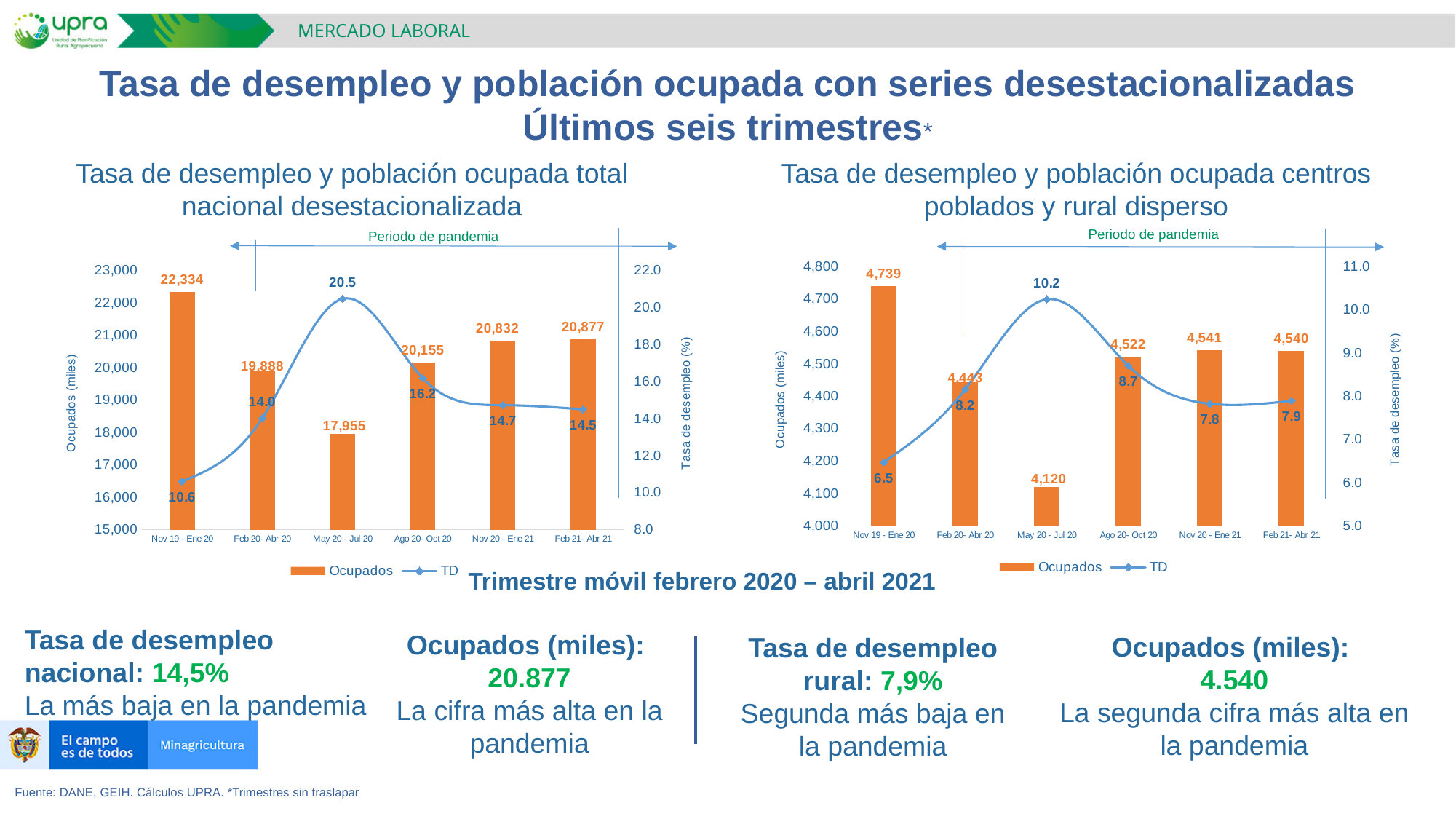
In the left chart (total nacional desestacionalizada), what is the difference in Ocupados between Feb 21- Abr 21 and Nov 20 - Ene 21? 45 In the left chart (total nacional desestacionalizada), what is the TD value for May 20 - Jul 20? 20.5 In the right chart (centros poblados y rural disperso), what is the difference in TD between May 20 - Jul 20 and Nov 19 - Ene 20? 3.7 In the right chart (centros poblados y rural disperso), what is the TD value for Nov 19 - Ene 20? 6.5 How many periods are shown on the x axis of the right chart (centros poblados y rural disperso)? 6 How many series does the legend of the left chart (total nacional desestacionalizada) list? 2 In the left chart (total nacional desestacionalizada), which is larger, the TD for Feb 20- Abr 20 or for Ago 20- Oct 20? Ago 20- Oct 20 In the left chart (total nacional desestacionalizada), what is the Ocupados value for Nov 19 - Ene 20? 22,334 What type of chart is the left chart (total nacional desestacionalizada)? Combined bar and line chart In the left chart (total nacional desestacionalizada), which period has the lowest Ocupados value? May 20 - Jul 20 In the right chart (centros poblados y rural disperso), what is the Ocupados value for Ago 20- Oct 20? 4,522 In the right chart (centros poblados y rural disperso), which period has the highest TD value? May 20 - Jul 20